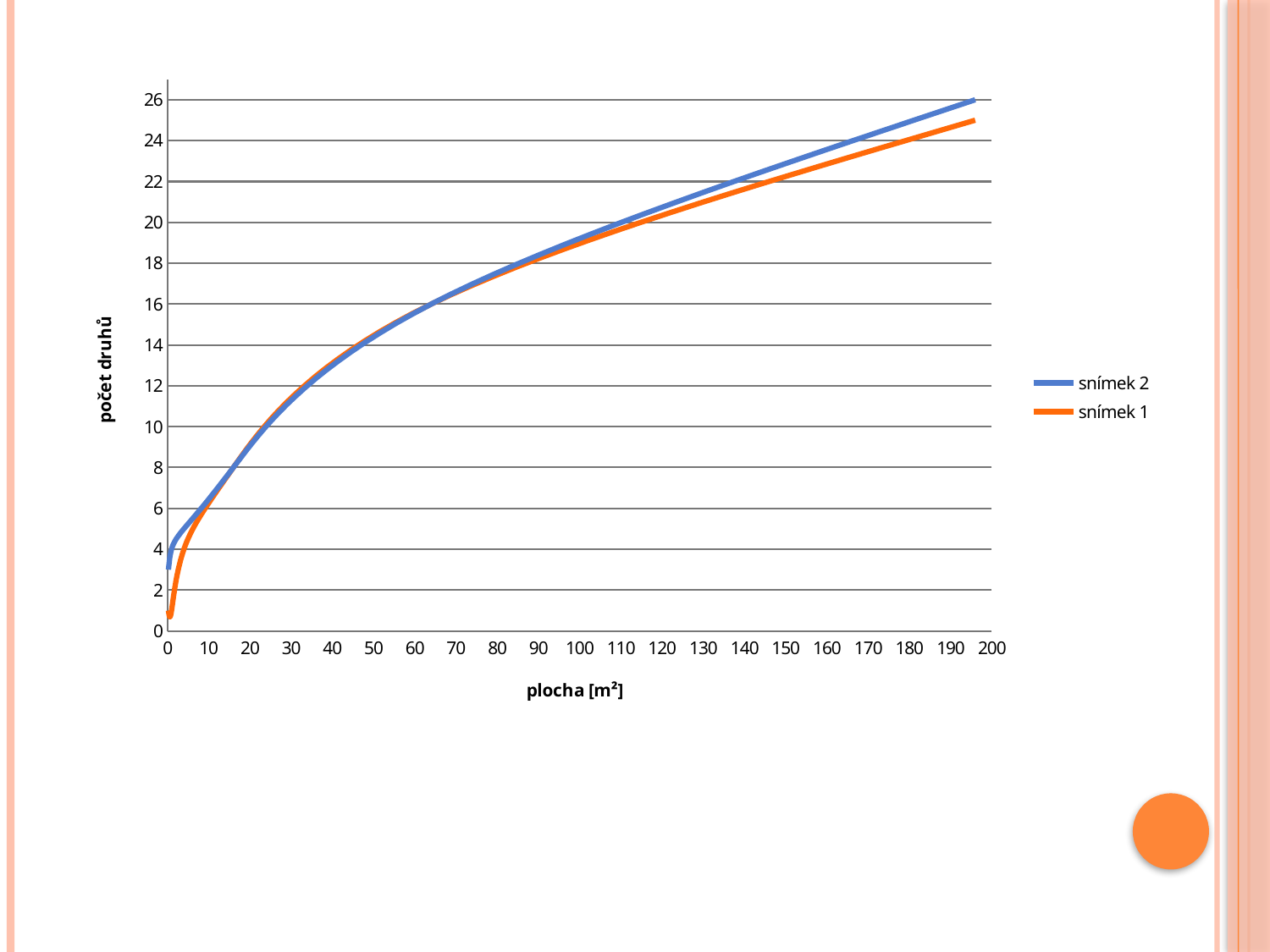
Is the value of snímek 1 at plocha 50 greater or less than 16? less At the right end of the chart (around 190 m²), which series has the higher počet druhů, snímek 1 or snímek 2? snímek 2 At the very start of the chart (plocha near 0), which series has the higher počet druhů, snímek 1 or snímek 2? snímek 2 Do the values of snímek 2 rise or fall as plocha increases along the x axis? rise What is the title of the x axis? plocha [m²] What are the names of the two series in the legend? snímek 2 and snímek 1 What kind of chart is shown on the slide? line chart Is the value of snímek 2 at plocha 190 greater or less than 24? greater Is the value of snímek 1 at plocha 100 greater or less than 16? greater How many series does the legend list? 2 Do the values of snímek 1 rise or fall as plocha increases along the x axis? rise